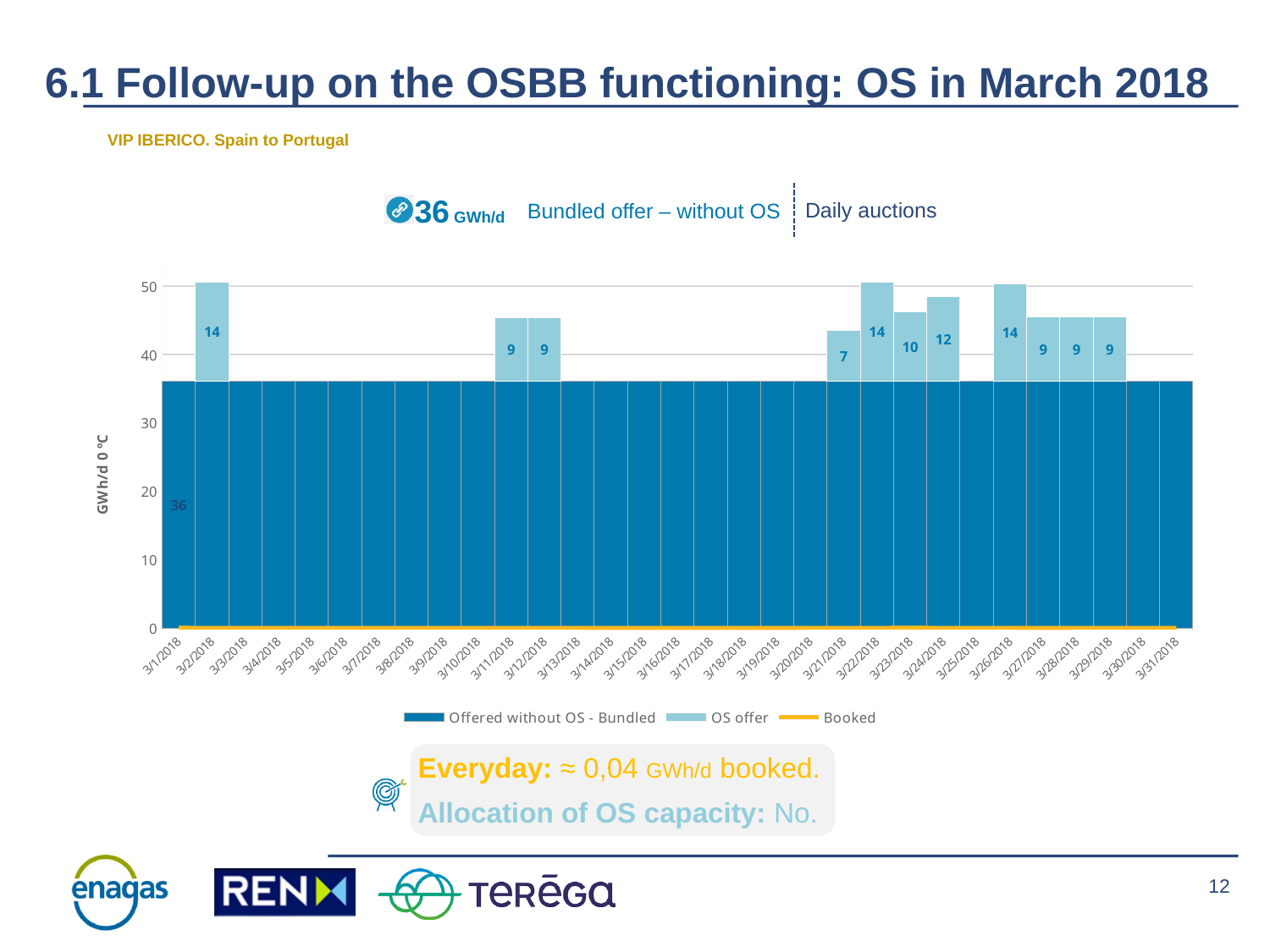
How many dates are shown on the x axis of the chart? 31 What is the OS offer value on 3/24/2018? 12 What is the total of the stacked bar (Offered without OS - Bundled plus OS offer) on 3/2/2018? 50 What is the OS offer value on 3/2/2018? 14 What is the total of the stacked bar (Offered without OS - Bundled plus OS offer) on 3/21/2018? 43 How many series does the legend list? 3 What is the OS offer value on 3/21/2018? 7 What kind of chart is shown on the slide? Bar chart What is the value of Offered without OS - Bundled on 3/1/2018? 36 What is the difference between the OS offer on 3/22/2018 and the OS offer on 3/23/2018? 4 Which date has a larger OS offer value, 3/24/2018 or 3/27/2018? 3/24/2018 Among the days with a labelled OS offer, which date has the lowest OS offer value? 3/21/2018